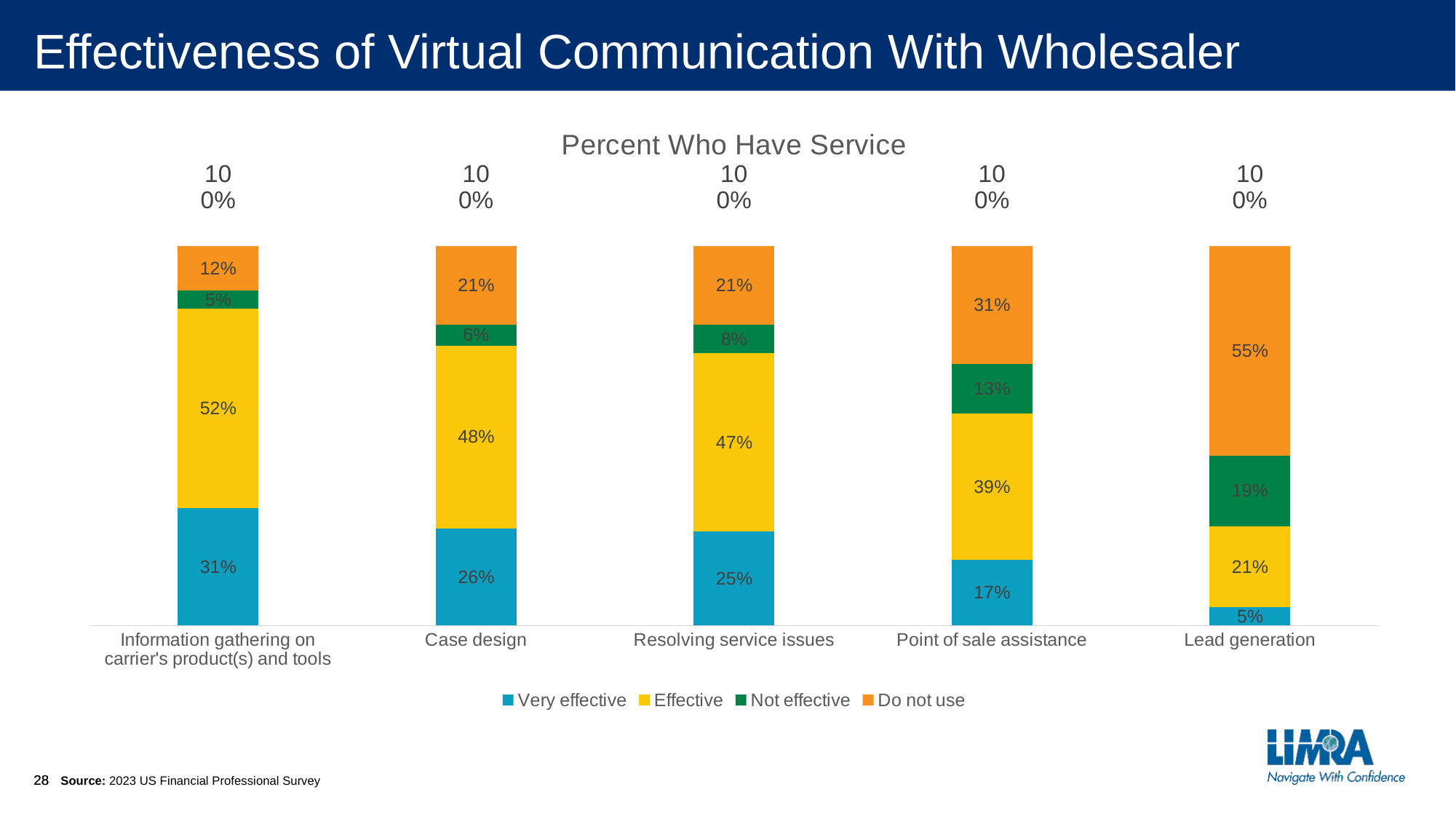
What is the title of the chart? Percent Who Have Service What is the 'Very effective' value for Case design? 26% What is the 'Not effective' value for Point of sale assistance? 13% Which is larger: the 'Not effective' value for Lead generation or for Resolving service issues? Lead generation How many categories are shown on the x axis? 5 What is the 'Effective' value for Resolving service issues? 47% Which category has the highest 'Very effective' value? Information gathering on carrier's product(s) and tools What is the 'Do not use' value for Lead generation? 55% What kind of chart is shown on the slide? stacked bar chart What is the difference between the 'Do not use' values for Point of sale assistance and Case design? 10% How many series does the legend list? 4 Which category has the lowest 'Effective' value? Lead generation